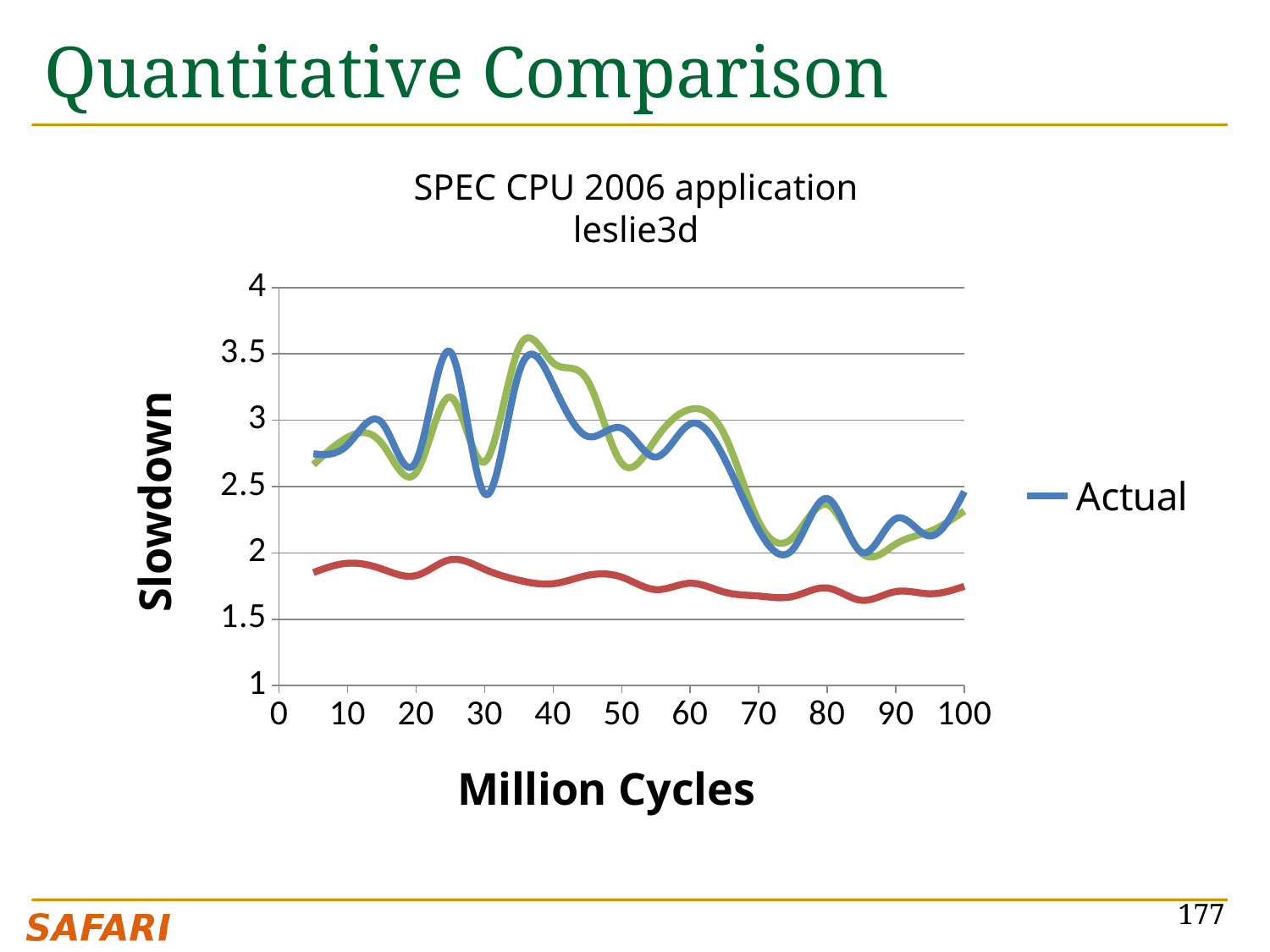
Between 60 and 75 million cycles, does the Actual line rise or fall? fall Between 85 and 100 million cycles, does the Actual line rise or fall? rise Is the Actual value at 40 million cycles greater or less than 3? greater Is the Actual value at 100 million cycles greater or less than 2? greater Is the Actual value at 25 million cycles greater or less than 3? greater How many series does the chart's legend list? 1 What kind of chart is shown on the slide? line chart What is the title of the chart? SPEC CPU 2006 application leslie3d What is the label of the y axis? Slowdown